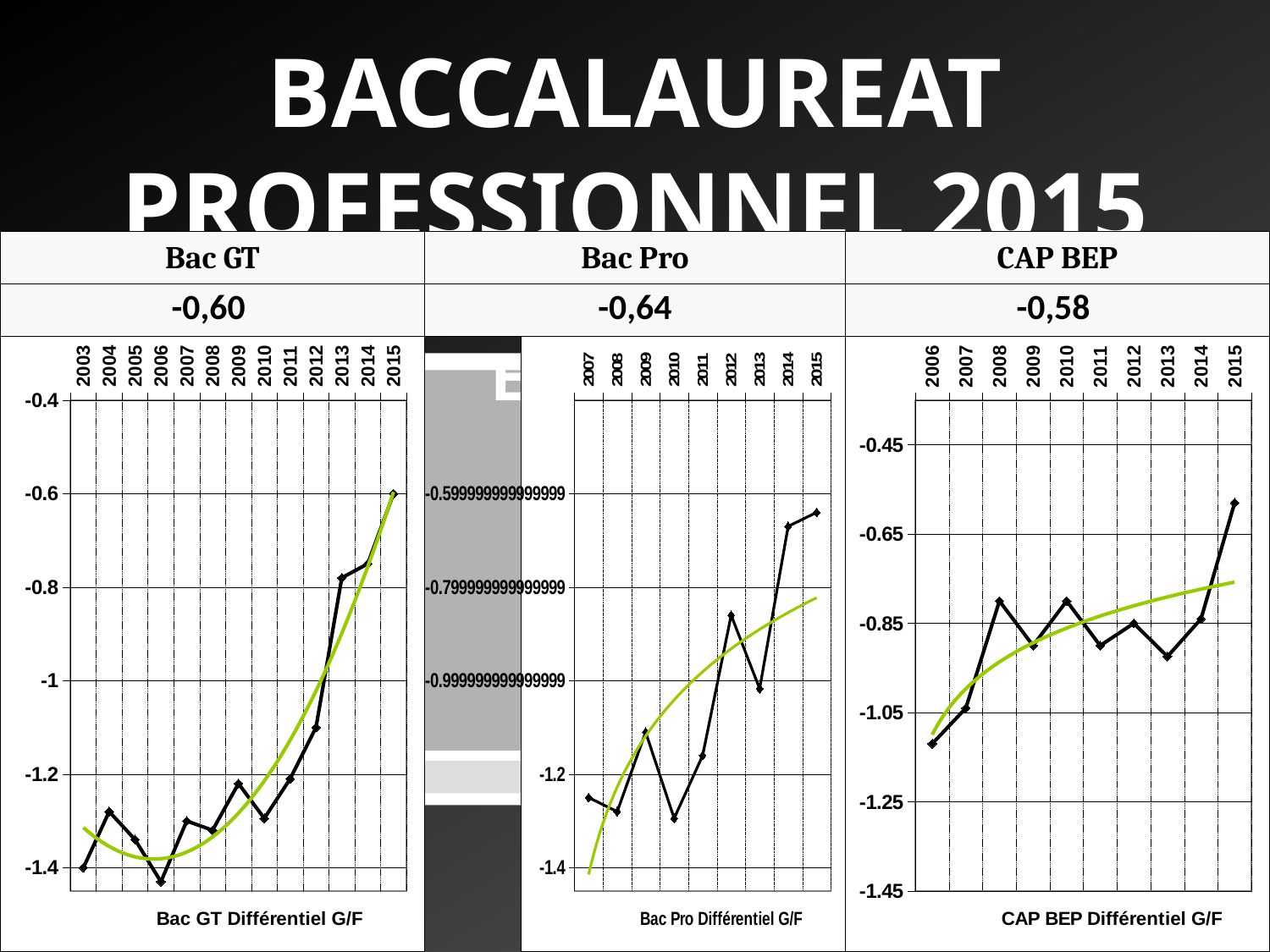
How many years are plotted on the CAP BEP Différentiel G/F chart? 10 On the CAP BEP Différentiel G/F chart, is the value for 2013 greater or less than -0.85? less On the Bac GT Différentiel G/F chart, do the values overall rise or fall from 2003 to 2015? rise On the CAP BEP Différentiel G/F chart, which year has the highest value? 2015 How many years are plotted on the Bac Pro Différentiel G/F chart? 9 What kind of chart is the Bac GT Différentiel G/F chart? line chart On the CAP BEP Différentiel G/F chart, which is larger, the value for 2008 or the value for 2009? 2008 How many years are plotted on the Bac GT Différentiel G/F chart? 13 On the Bac GT Différentiel G/F chart, which year has the highest value? 2015 On the Bac Pro Différentiel G/F chart, is the value for 2007 greater or less than -1.2? less On the CAP BEP Différentiel G/F chart, which year has the lowest value? 2006 On the Bac GT Différentiel G/F chart, which year has the lowest value? 2006